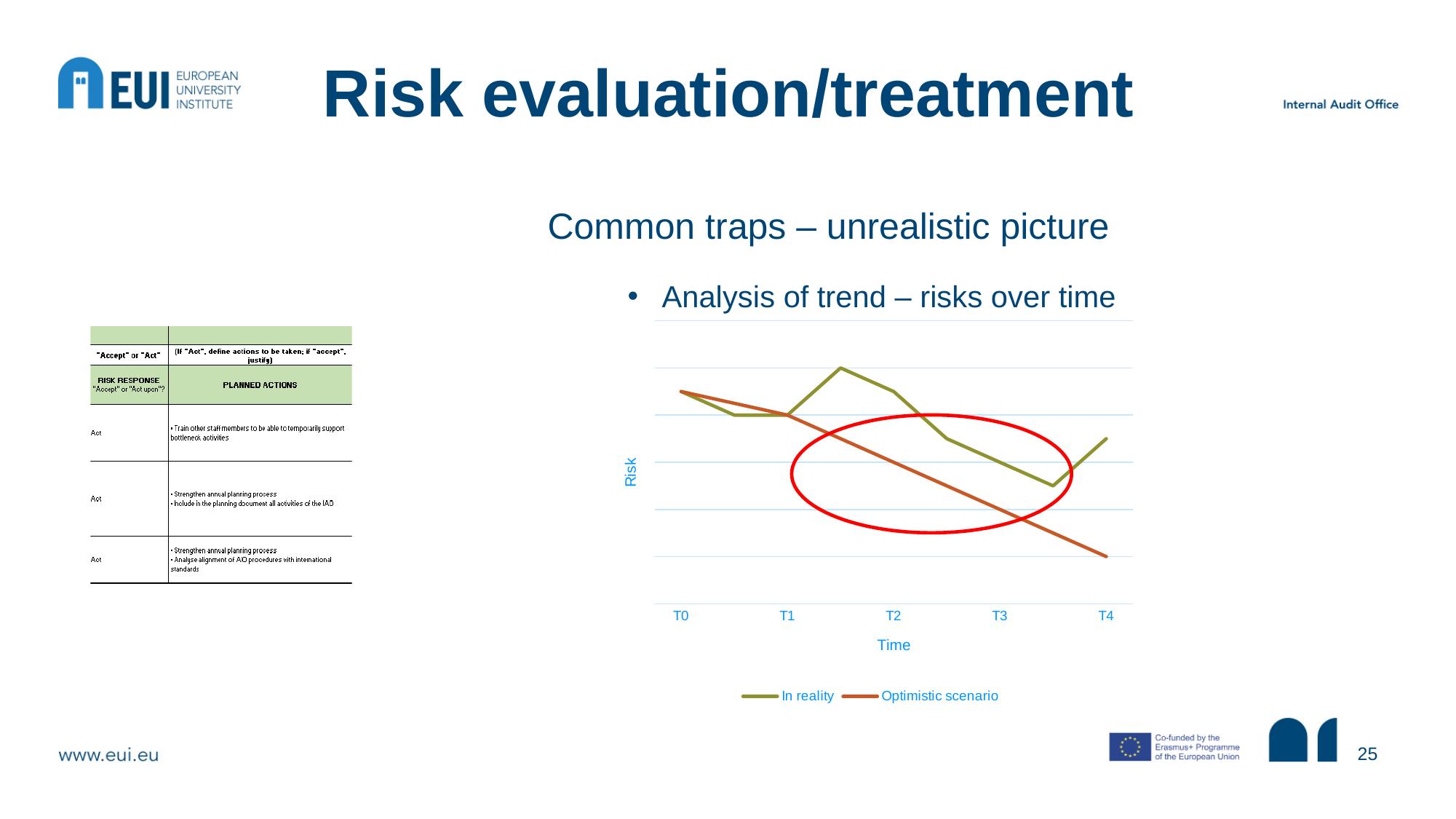
Does the 'Optimistic scenario' line rise or fall from T0 to T4? Fall What kind of chart is shown on the slide? Line chart How many labelled time points are shown on the x axis of the chart? 5 Which series is drawn in green on the chart? In reality How many series does the chart legend list? 2 What is the label of the x axis of the chart? Time Does the 'In reality' line rise or fall between T3 and T4? Rise At which labelled time point does the 'Optimistic scenario' line reach its lowest value? T4 What are the two series named in the chart legend? In reality; Optimistic scenario At which labelled time point does the 'Optimistic scenario' line have its highest value? T0 At T3, which series has the higher risk value: 'In reality' or 'Optimistic scenario'? In reality At T4, which series has the higher risk value: 'In reality' or 'Optimistic scenario'? In reality